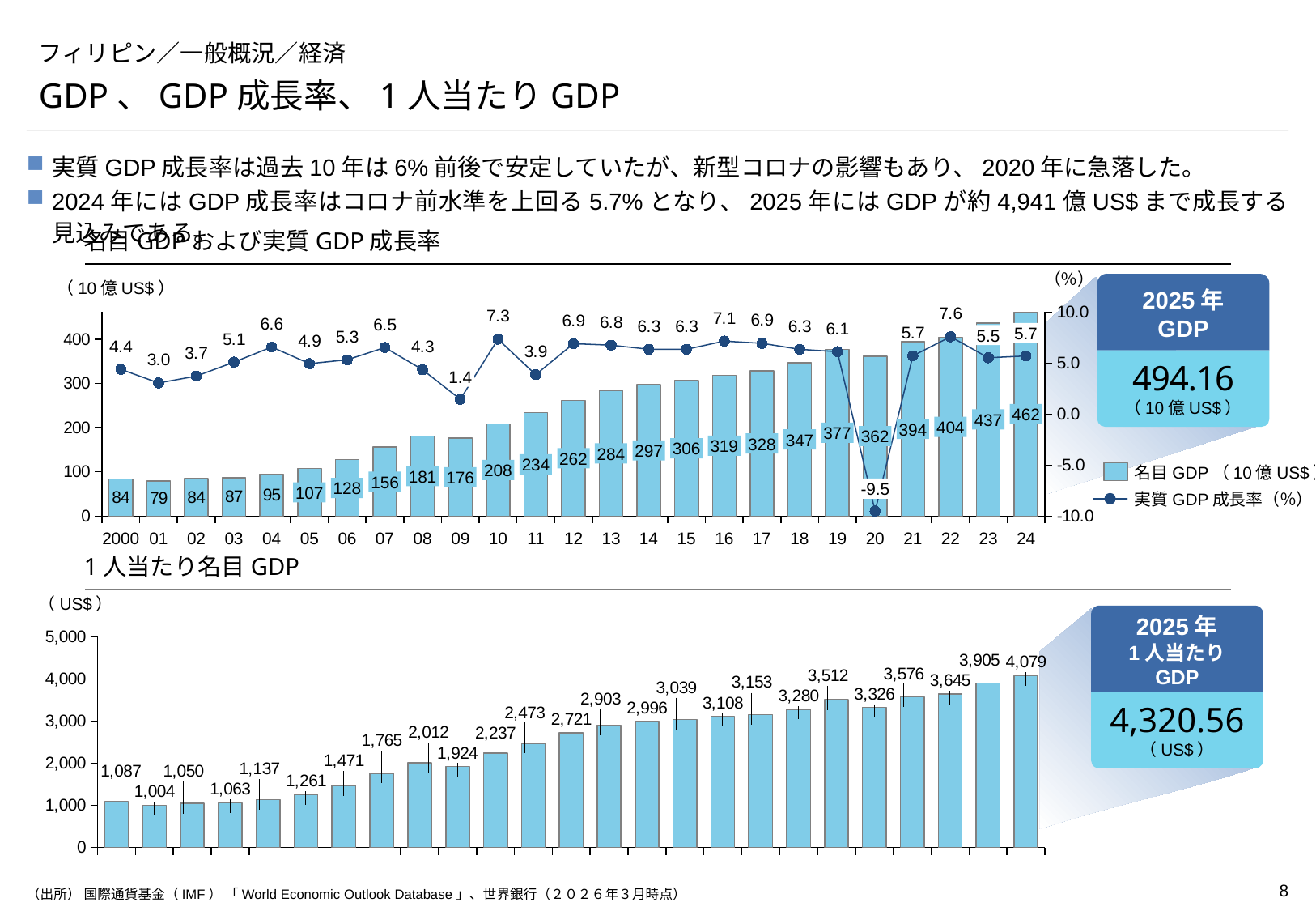
In the top chart (名目GDPおよび実質GDP成長率), what is the nominal GDP value for 2020? 362 In the bottom chart (1人当たり名目GDP), what is the value of the tallest bar? 4,079 In the top chart (名目GDPおよび実質GDP成長率), which year has the lowest real GDP growth rate? 2020 In the top chart (名目GDPおよび実質GDP成長率), what is the real GDP growth rate for 2024? 5.7 In the top chart (名目GDPおよび実質GDP成長率), which is larger, the nominal GDP for 2019 or for 2020? 2019 What kind of chart is the bottom chart (1人当たり名目GDP)? Bar chart In the top chart (名目GDPおよび実質GDP成長率), how many series does the legend list? 2 In the bottom chart (1人当たり名目GDP), how many bars are plotted? 25 In the bottom chart (1人当たり名目GDP), what is the value of the lowest bar? 1,004 In the top chart (名目GDPおよび実質GDP成長率), what is the difference in nominal GDP between 2024 and 2023? 25 In the top chart (名目GDPおよび実質GDP成長率), which year has the highest real GDP growth rate? 2022 In the top chart (名目GDPおよび実質GDP成長率), what is the real GDP growth rate for 2009? 1.4